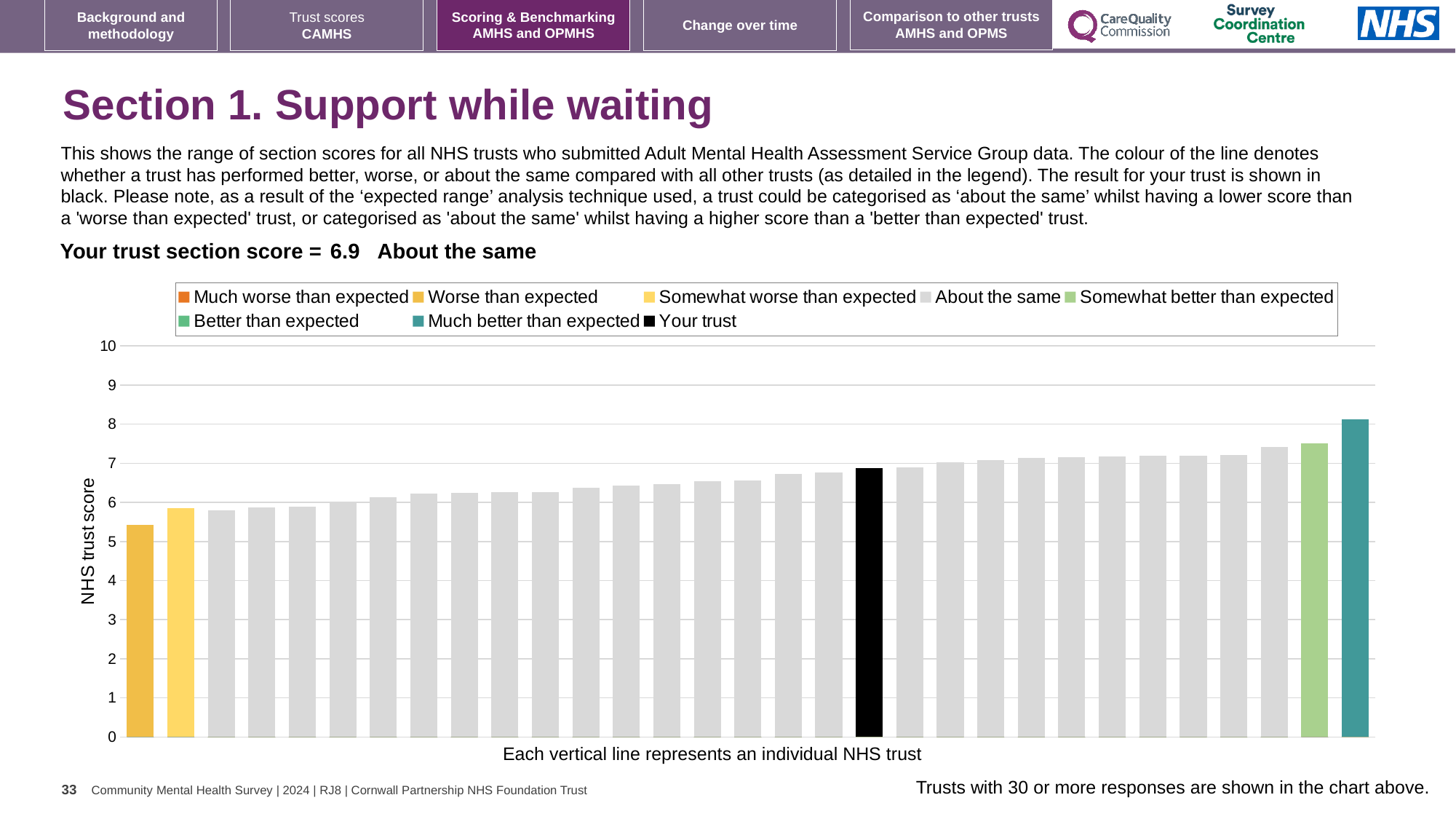
Do the bar values rise or fall from left to right across the chart? rise How many entries does the chart legend list? 8 What kind of chart is shown on the slide? bar chart What is the section score for your trust shown on the slide? 6.9 What is the label on the vertical axis of the chart? NHS trust score Is the value of the black 'Your trust' bar greater or less than 6? greater Is the value of the leftmost bar greater or less than 6? less Which legend category does the lowest bar in the chart belong to? Worse than expected Is the value of the rightmost bar greater or less than 7? greater Which legend category does the highest bar in the chart belong to? Much better than expected Which performance category is your trust placed in for this section? About the same Which is taller, the black 'Your trust' bar or the leftmost bar? the black 'Your trust' bar